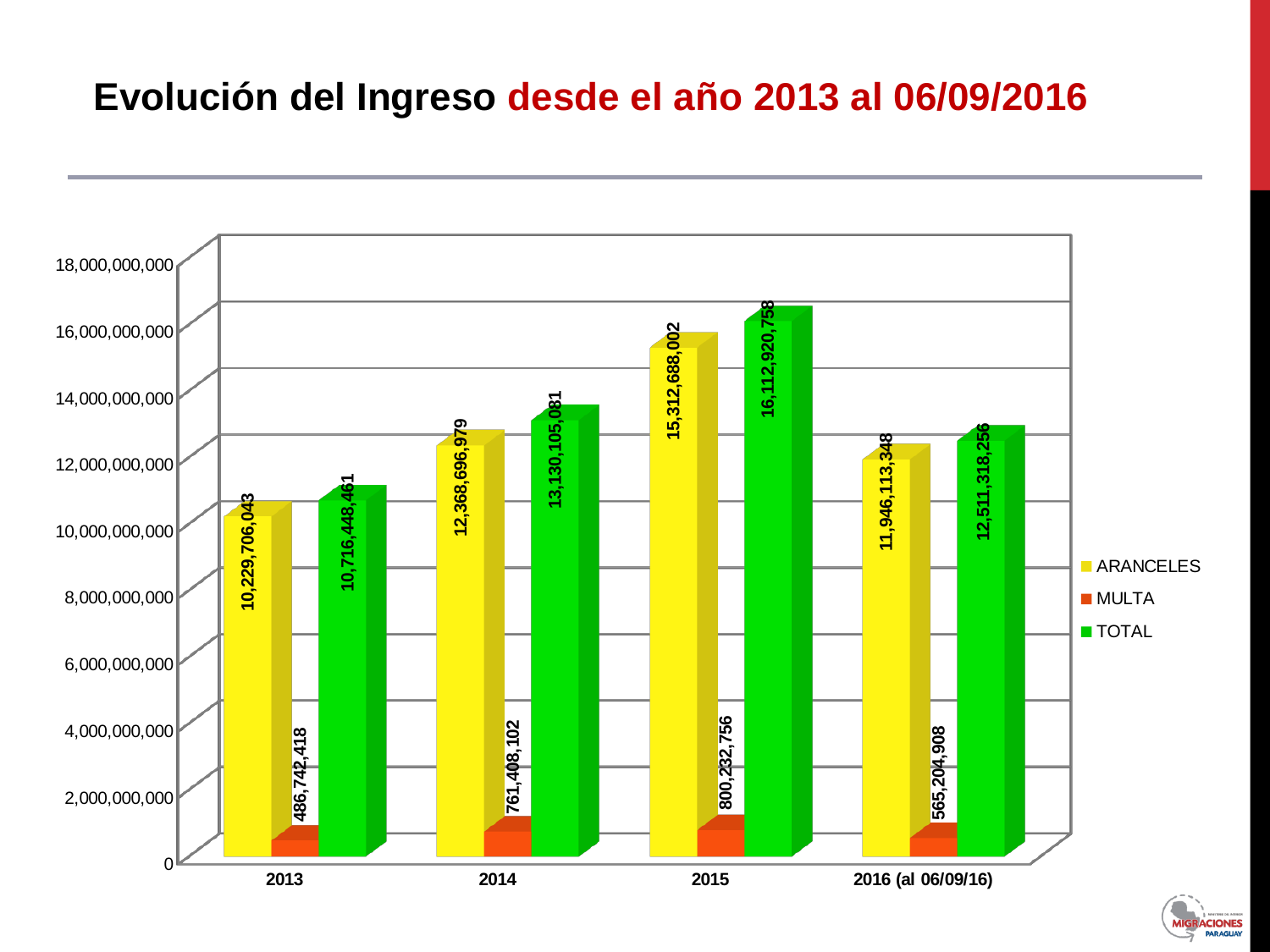
How many series does the legend list? 3 Which year has the highest TOTAL value? 2015 What kind of chart is shown on the slide? Bar chart Which series is shown in green in the legend? TOTAL What is the TOTAL value for 2015? 16,112,920,758 Which is larger, the ARANCELES value for 2014 or for 2016 (al 06/09/16)? 2014 What is the TOTAL value for 2016 (al 06/09/16)? 12,511,318,256 Which year has the lowest MULTA value? 2013 What is the difference between the TOTAL values for 2015 and 2014? 2,982,815,677 What is the ARANCELES value for 2013? 10,229,706,043 What is the MULTA value for 2014? 761,408,102 Is the ARANCELES value for 2015 greater or less than 14,000,000,000? greater